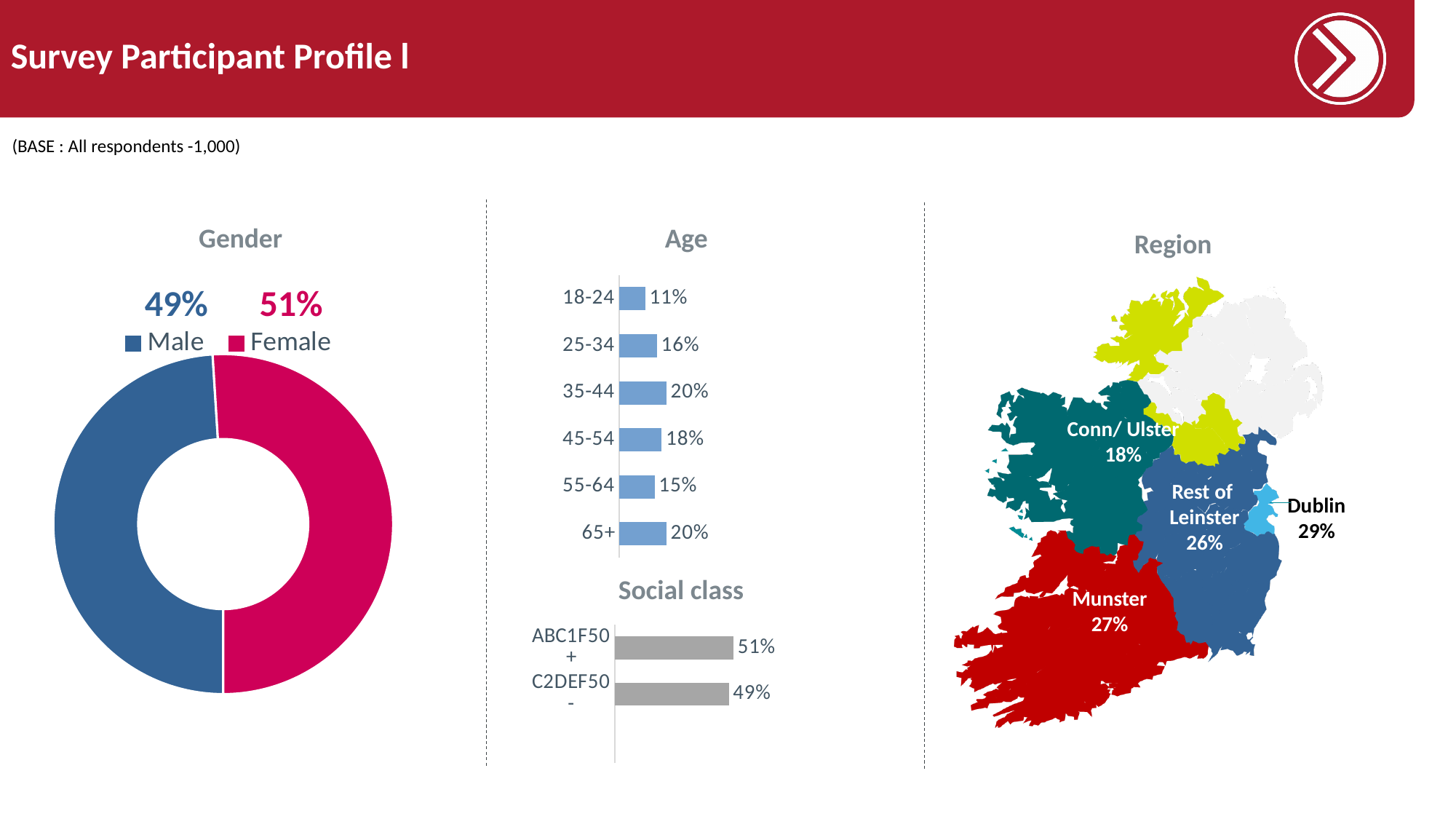
What kind of chart is the Gender chart? Donut (pie) chart In the Region map, what percentage of respondents are from Munster? 27% In the Social class chart, which category has the highest value? ABC1F50+ In the Age chart, what is the difference between the 35-44 and 25-34 values? 4% In the Social class chart, what is the value for C2DEF50-? 49% In the Age chart, what is the value for the 45-54 age group? 18% How many age groups are shown in the Age chart? 6 In the Gender chart, what percentage of respondents are Female? 51% What kind of chart is the Age chart? Bar chart How many series does the legend of the Gender chart list? 2 In the Gender chart, which is larger, Male or Female? Female In the Age chart, which age group has the lowest value? 18-24